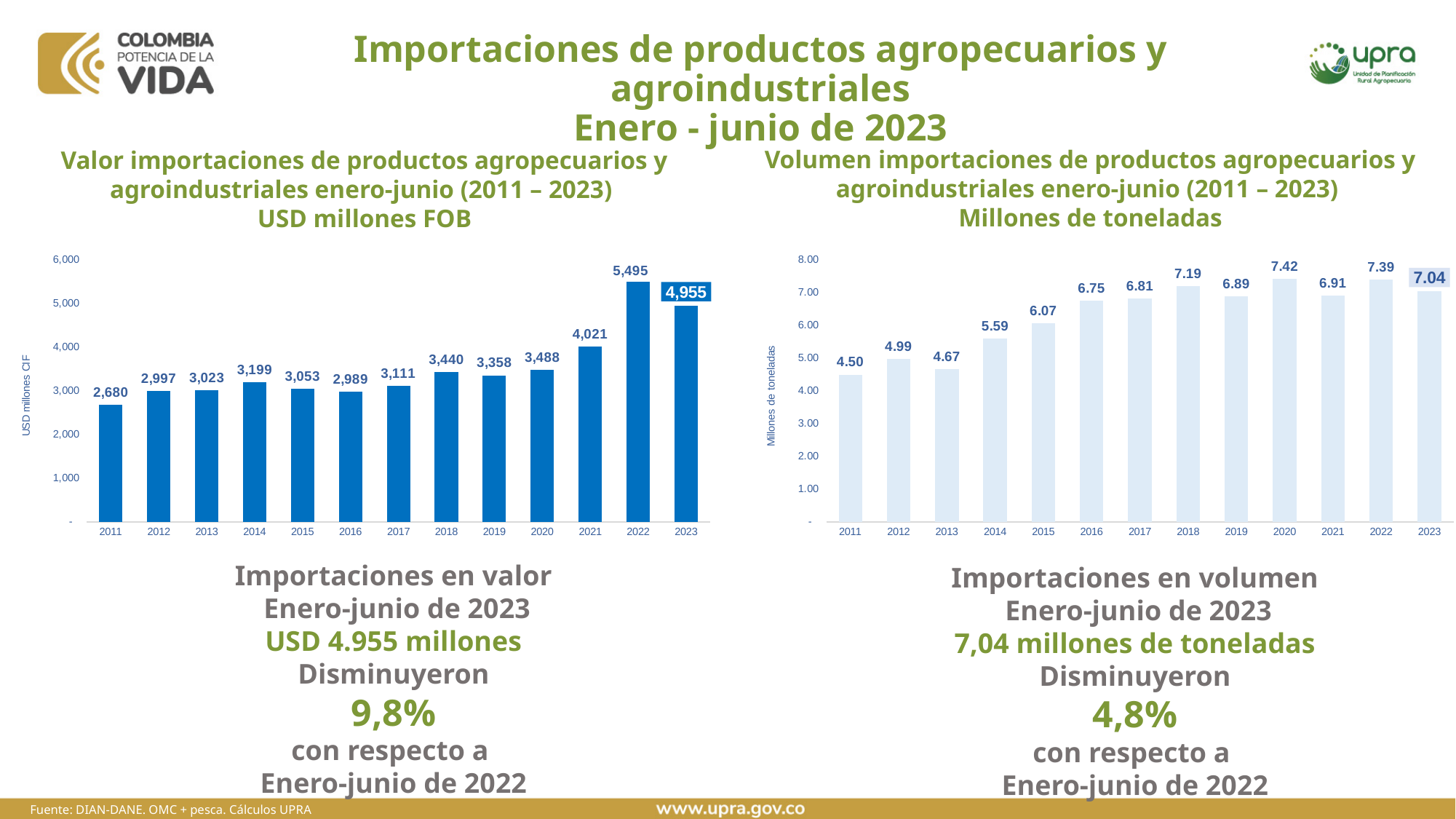
In the right chart (Volumen importaciones, Millones de toneladas), what is the value for 2020? 7.42 In the left chart (Valor importaciones, USD millones FOB), which is larger, the value for 2018 or the value for 2019? 2018 In the left chart (Valor importaciones, USD millones FOB), which year has the highest value? 2022 In the left chart (Valor importaciones, USD millones FOB), what is the value for 2023? 4,955 In the right chart (Volumen importaciones, Millones de toneladas), is the value for 2015 greater or less than 6.00? greater In the right chart (Volumen importaciones, Millones de toneladas), which year has the lowest value? 2011 In the left chart (Valor importaciones, USD millones FOB), how many years are shown on the x axis? 13 In the right chart (Volumen importaciones, Millones de toneladas), what is the difference between the 2022 and 2023 values? 0.35 In the left chart (Valor importaciones, USD millones FOB), what is the label on the vertical axis? USD millones CIF In the left chart (Valor importaciones, USD millones FOB), which year has the lowest value? 2011 What kind of chart is the right chart (Volumen importaciones, Millones de toneladas)? Bar chart In the left chart (Valor importaciones, USD millones FOB), what is the difference between the 2022 and 2023 values? 540